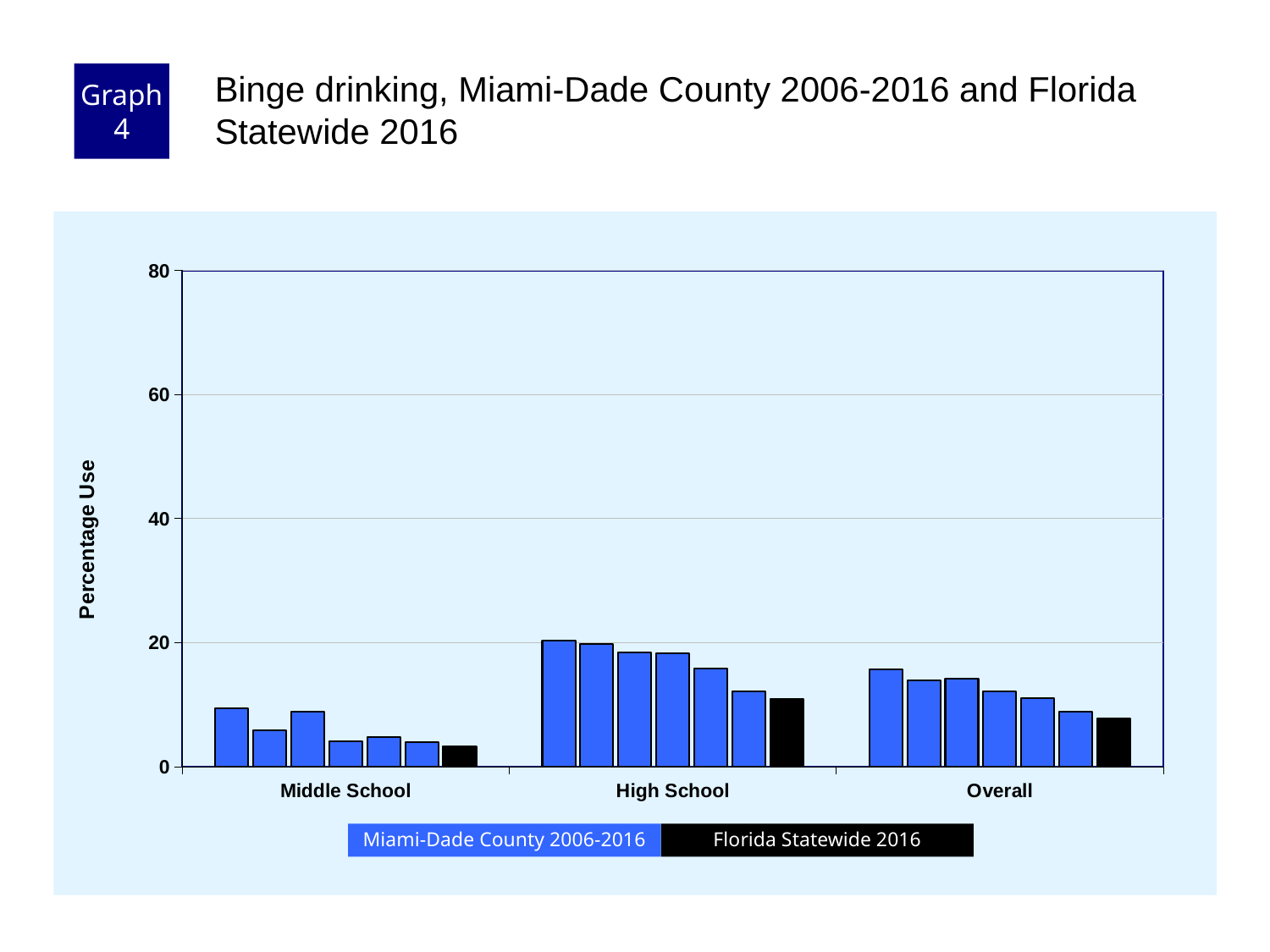
Do the Miami-Dade County bars for High School rise or fall from left to right? fall Which category has the highest bars? High School What kind of chart is shown on the slide? bar chart Which category has the lowest bars? Middle School Is the Florida Statewide 2016 value for Middle School greater or less than 20? less How many series does the legend list? 2 What colour are the Florida Statewide 2016 bars? black How many categories are shown along the x axis? 3 Which is larger, the Florida Statewide 2016 bar for High School or the Florida Statewide 2016 bar for Middle School? High School Is the Florida Statewide 2016 value for High School greater or less than 20? less What is the label on the y axis? Percentage Use Are all the Overall bars greater or less than 20? less